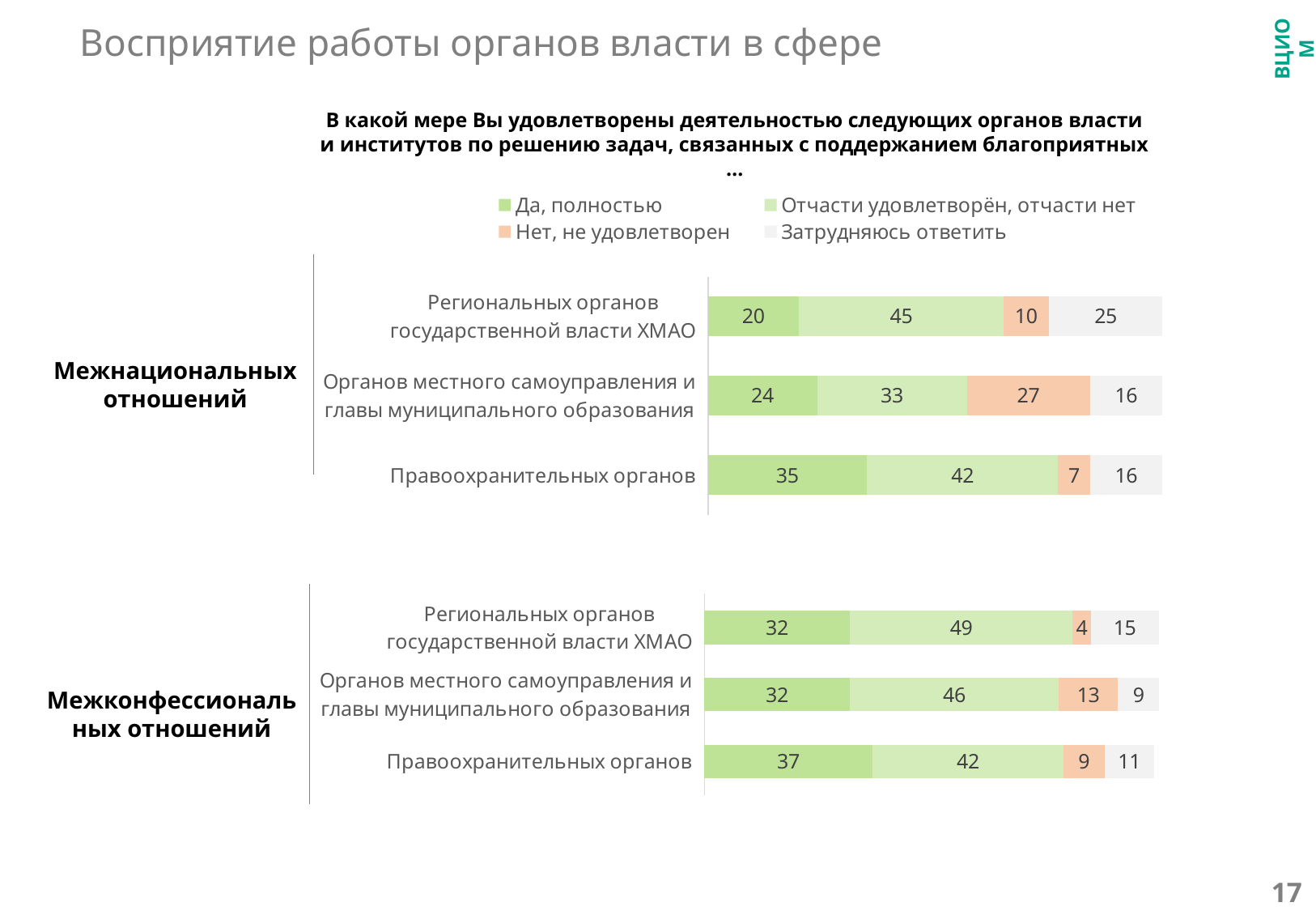
In the top chart (Межнациональных отношений), which category has the highest 'Да, полностью' value? Правоохранительных органов What type of chart is used on this slide? Stacked bar chart How many series does the legend list? 4 In the top chart (Межнациональных отношений), which category has the lowest 'Нет, не удовлетворен' value? Правоохранительных органов In the bottom chart (Межконфессиональных отношений), what is the difference between the 'Нет, не удовлетворен' values for Органов местного самоуправления и главы муниципального образования and Региональных органов государственной власти ХМАО? 9 Which legend entry is shown in orange? Нет, не удовлетворен In the top chart (Межнациональных отношений), what is the value of 'Да, полностью' for Правоохранительных органов? 35 In the bottom chart (Межконфессиональных отношений), what is the value of 'Отчасти удовлетворён, отчасти нет' for Региональных органов государственной власти ХМАО? 49 In the top chart (Межнациональных отношений), which is larger: 'Затрудняюсь ответить' for Региональных органов государственной власти ХМАО or for Правоохранительных органов? Региональных органов государственной власти ХМАО How many categories are shown in the bottom chart (Межконфессиональных отношений)? 3 In the top chart (Межнациональных отношений), what is the value of 'Нет, не удовлетворен' for Органов местного самоуправления и главы муниципального образования? 27 In the bottom chart (Межконфессиональных отношений), what is the value of 'Затрудняюсь ответить' for Правоохранительных органов? 11